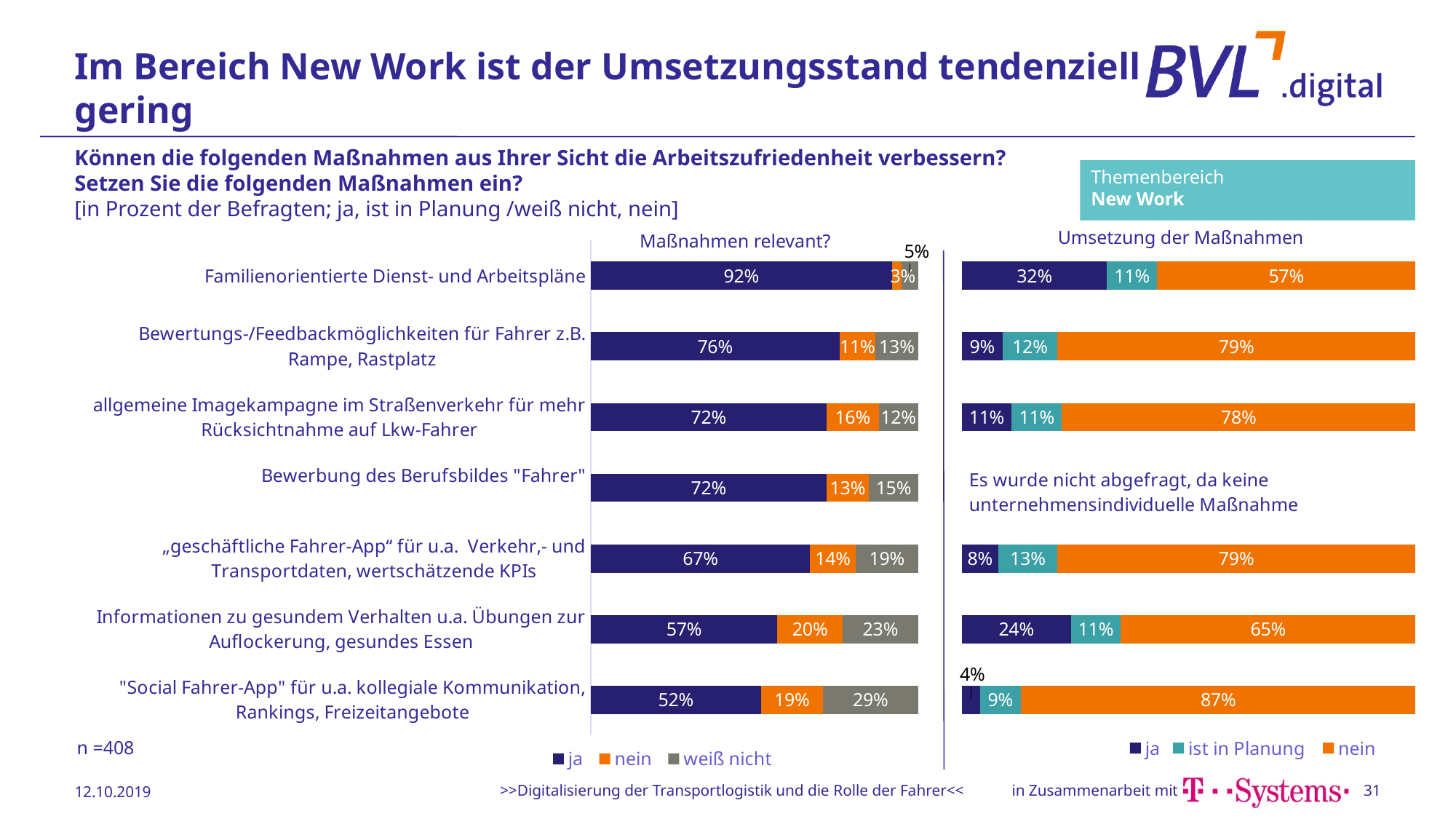
In the "Maßnahmen relevant?" chart, which category has the lowest "ja" value? "Social Fahrer-App" für u.a. kollegiale Kommunikation, Rankings, Freizeitangebote In the "Maßnahmen relevant?" chart, what is the difference between the "weiß nicht" values for "Social Fahrer-App" and "Familienorientierte Dienst- und Arbeitspläne"? 24 percentage points In the "Umsetzung der Maßnahmen" chart, what is the "nein" value for "Social Fahrer-App"? 87% In the "Maßnahmen relevant?" chart, what is the "nein" value for "Informationen zu gesundem Verhalten"? 20% In the "Umsetzung der Maßnahmen" chart, which is larger: the "ja" value for "Informationen zu gesundem Verhalten" or for "allgemeine Imagekampagne"? Informationen zu gesundem Verhalten Which series are listed in the legend of the "Maßnahmen relevant?" chart? ja, nein, weiß nicht In the "Umsetzung der Maßnahmen" chart, what is the "ist in Planung" value for "geschäftliche Fahrer-App"? 13% In the "Maßnahmen relevant?" chart, what is the "ja" value for "Familienorientierte Dienst- und Arbeitspläne"? 92% How many series does the legend of the "Umsetzung der Maßnahmen" chart list? 3 How many categories are shown in the "Maßnahmen relevant?" chart? 7 What kind of chart is the "Maßnahmen relevant?" chart? Stacked horizontal bar chart In the "Umsetzung der Maßnahmen" chart, which category has the highest "ja" value? Familienorientierte Dienst- und Arbeitspläne